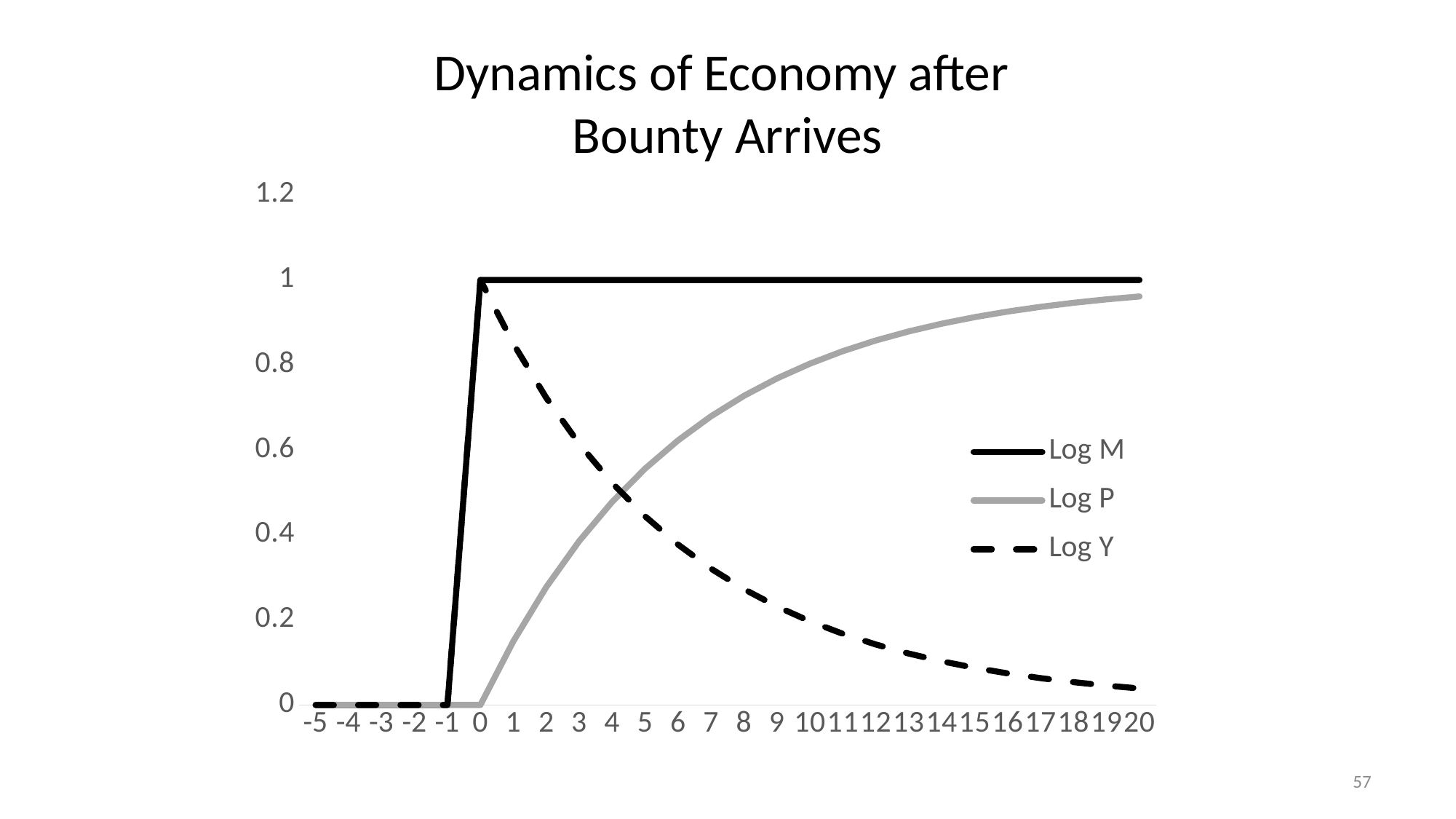
What kind of chart is shown on the slide? line chart Is the value of Log P at x = 1 greater or less than 0.4? less How many series does the legend list? 3 What is the value of Log M at x = 10? 1 Which series is drawn with a dashed line? Log Y Is the value of Log P at x = 10 greater or less than 0.6? greater What is the value of Log P at x = -2? 0 At x = 15, which is larger, Log P or Log Y? Log P What is the title of the chart? Dynamics of Economy after Bounty Arrives Is the value of Log Y at x = 10 greater or less than 0.4? less What is the value of Log M at x = -3? 0 Does Log Y rise or fall as x increases from 0 to 20? fall